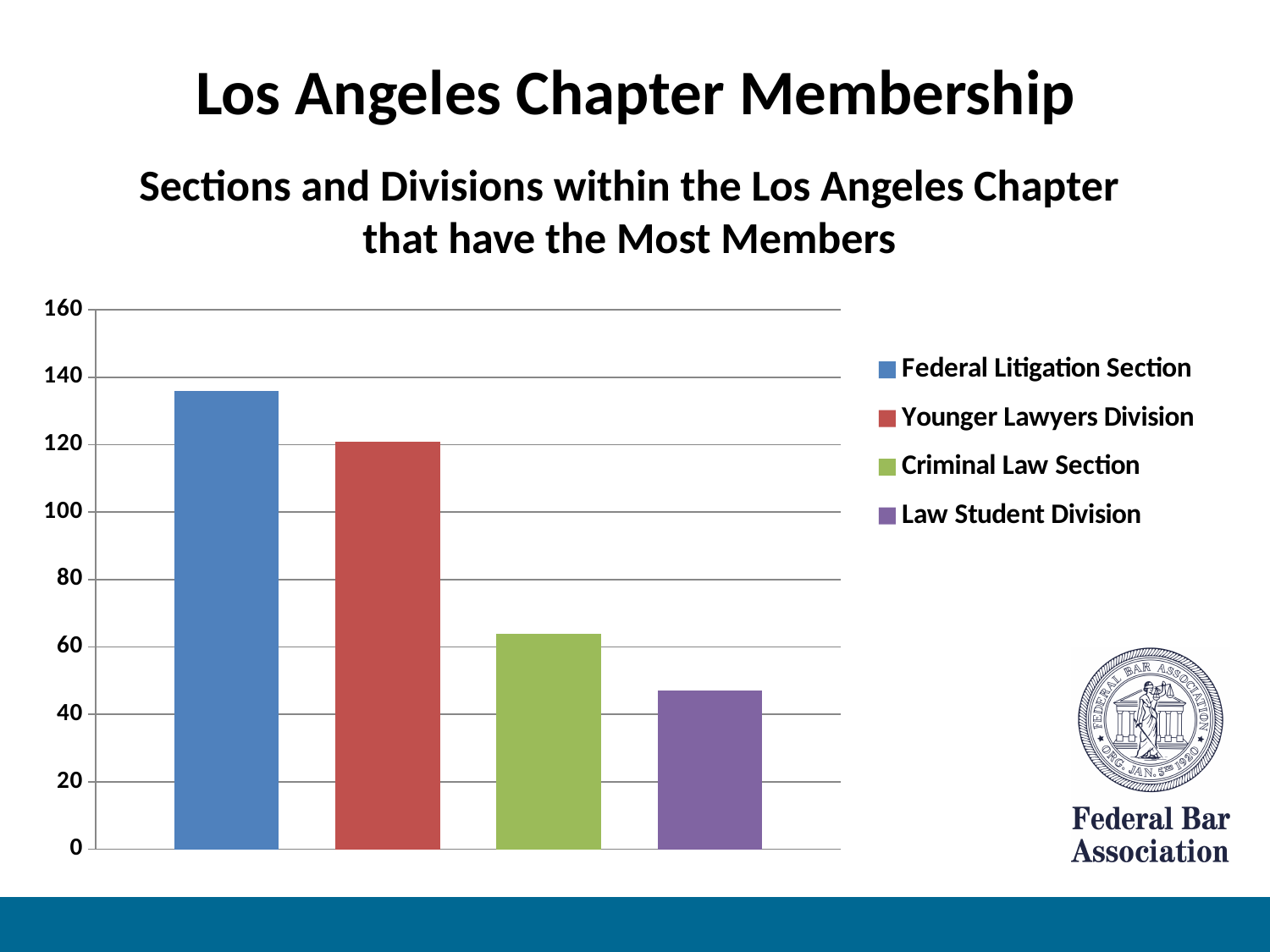
Which section or division has the highest number of members in the chart? Federal Litigation Section Is the value for the Criminal Law Section greater or less than 80? less How many bars are plotted in the chart? 4 Which has more members, the Younger Lawyers Division or the Criminal Law Section? Younger Lawyers Division Which section or division has the lowest number of members in the chart? Law Student Division How many entries does the chart legend list? 4 Is the value for the Younger Lawyers Division greater or less than 140? less Is the value for the Federal Litigation Section greater or less than 120? greater Do the bar values rise or fall from left to right across the chart? fall Which has more members, the Criminal Law Section or the Law Student Division? Criminal Law Section What kind of chart is shown on the slide? bar chart